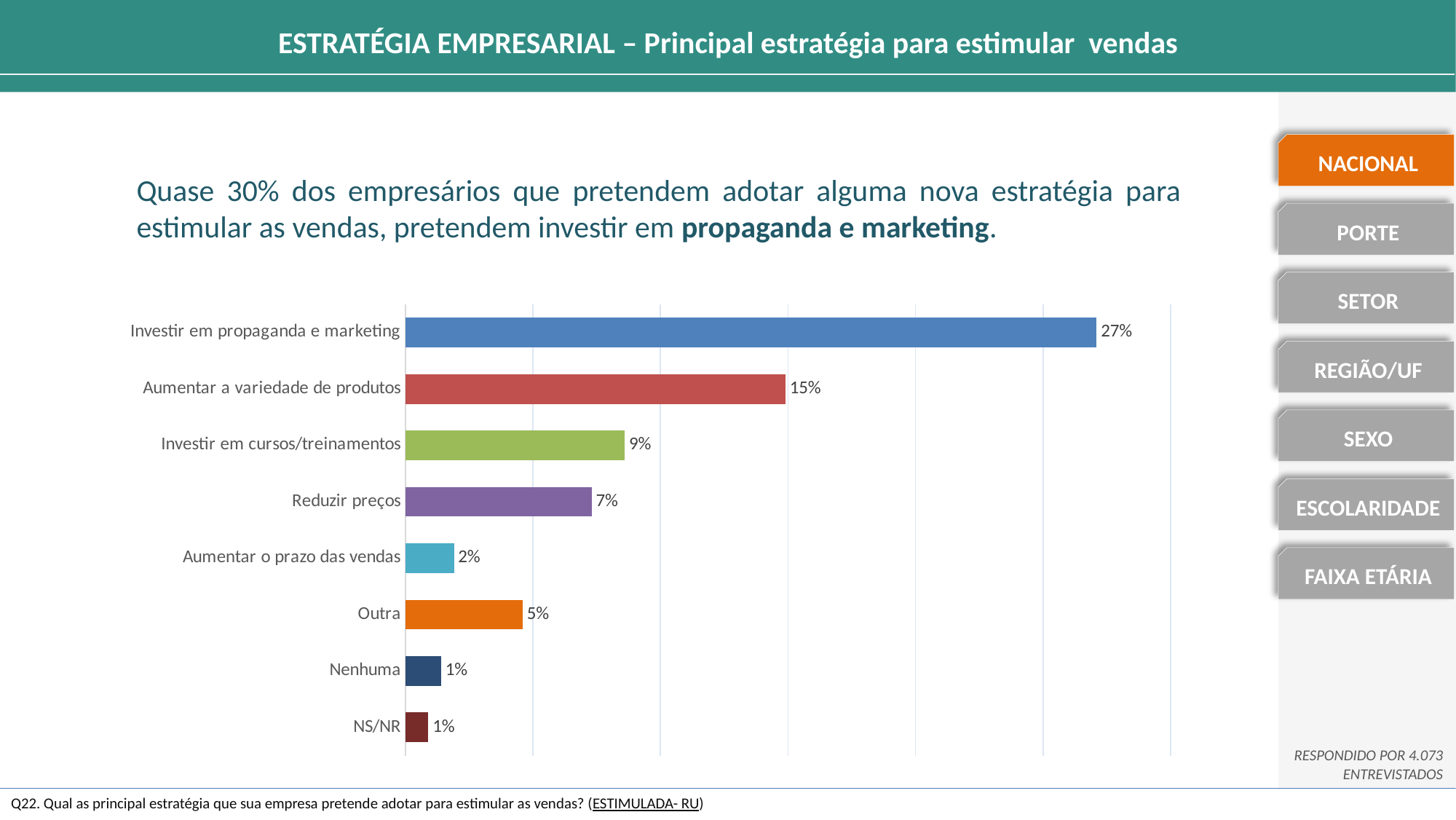
What is the value for "Outra"? 5% Which is larger, "Investir em cursos/treinamentos" or "Aumentar a variedade de produtos"? Aumentar a variedade de produtos Which category has the highest value? Investir em propaganda e marketing Which is larger, "Outra" or "Aumentar o prazo das vendas"? Outra What is the value for "Reduzir preços"? 7% What is the value for "Investir em propaganda e marketing"? 27% What is the difference between "Investir em propaganda e marketing" and "Aumentar a variedade de produtos"? 12% What is the value for "Aumentar o prazo das vendas"? 2% What kind of chart is shown on the slide? Bar chart What is the value for "Aumentar a variedade de produtos"? 15% How many categories are shown in the chart? 8 What is the difference between "Investir em cursos/treinamentos" and "Reduzir preços"? 2%